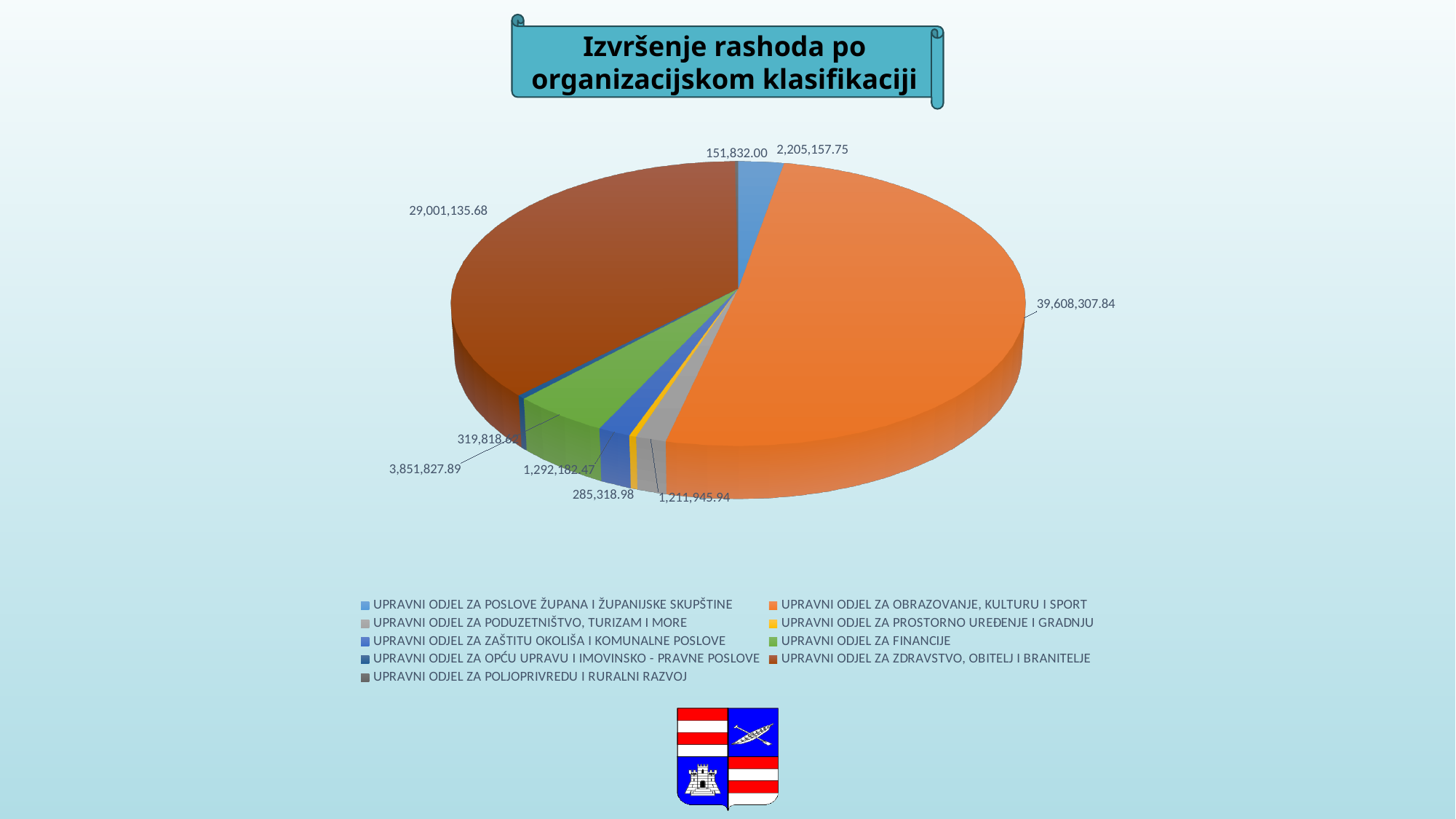
What is the difference between the values for UPRAVNI ODJEL ZA OBRAZOVANJE, KULTURU I SPORT and UPRAVNI ODJEL ZA ZDRAVSTVO, OBITELJ I BRANITELJE? 10,607,172.16 What is the title of the chart? Izvršenje rashoda po organizacijskom klasifikaciji What is the value for UPRAVNI ODJEL ZA ZDRAVSTVO, OBITELJ I BRANITELJE? 29,001,135.68 What is the value for UPRAVNI ODJEL ZA OBRAZOVANJE, KULTURU I SPORT? 39,608,307.84 What is the value for UPRAVNI ODJEL ZA ZAŠTITU OKOLIŠA I KOMUNALNE POSLOVE? 1,292,182.47 What is the value for UPRAVNI ODJEL ZA PROSTORNO UREĐENJE I GRADNJU? 285,318.98 What is the value for UPRAVNI ODJEL ZA PODUZETNIŠTVO, TURIZAM I MORE? 1,211,945.94 How many entries does the legend list? 9 What kind of chart is shown on the slide? pie chart What is the value for UPRAVNI ODJEL ZA FINANCIJE? 3,851,827.89 Which is larger, the value for UPRAVNI ODJEL ZA FINANCIJE or the value for UPRAVNI ODJEL ZA POSLOVE ŽUPANA I ŽUPANIJSKE SKUPŠTINE? UPRAVNI ODJEL ZA FINANCIJE Which category has the largest slice of the pie? UPRAVNI ODJEL ZA OBRAZOVANJE, KULTURU I SPORT